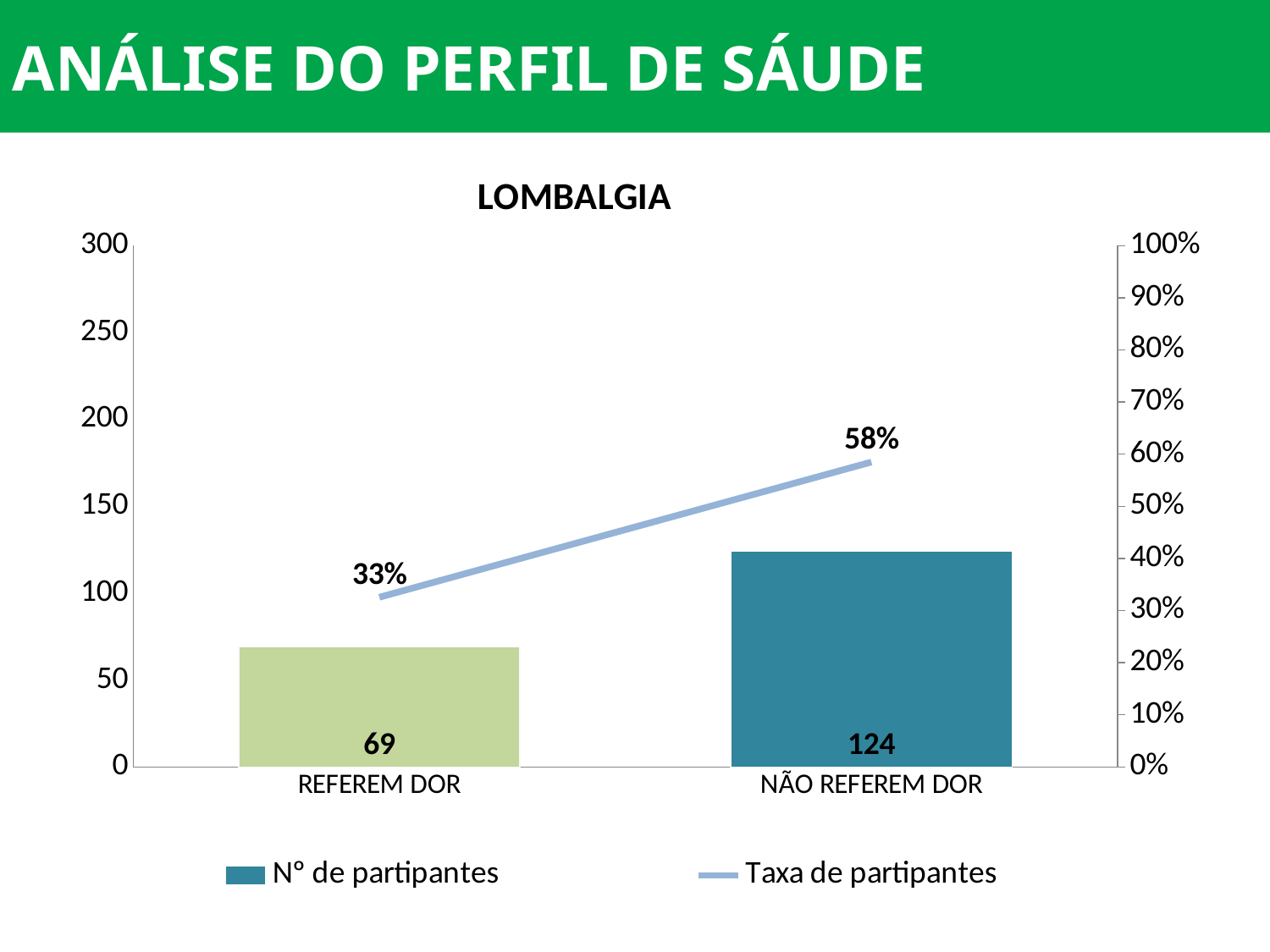
What is the Taxa de partipantes for NÃO REFEREM DOR? 58% Does the Taxa de partipantes line rise or fall from REFEREM DOR to NÃO REFEREM DOR? rise What is the number of participants (Nº de partipantes) for NÃO REFEREM DOR? 124 Which is larger: the number of participants for REFEREM DOR or for NÃO REFEREM DOR? NÃO REFEREM DOR What is the title of the chart? LOMBALGIA What is the Taxa de partipantes for REFEREM DOR? 33% What is the difference in number of participants between NÃO REFEREM DOR and REFEREM DOR? 55 Which category has the lowest Taxa de partipantes? REFEREM DOR Which category has the highest number of participants? NÃO REFEREM DOR How many series does the legend list? 2 What is the number of participants (Nº de partipantes) for REFEREM DOR? 69 How many categories are shown on the x axis? 2